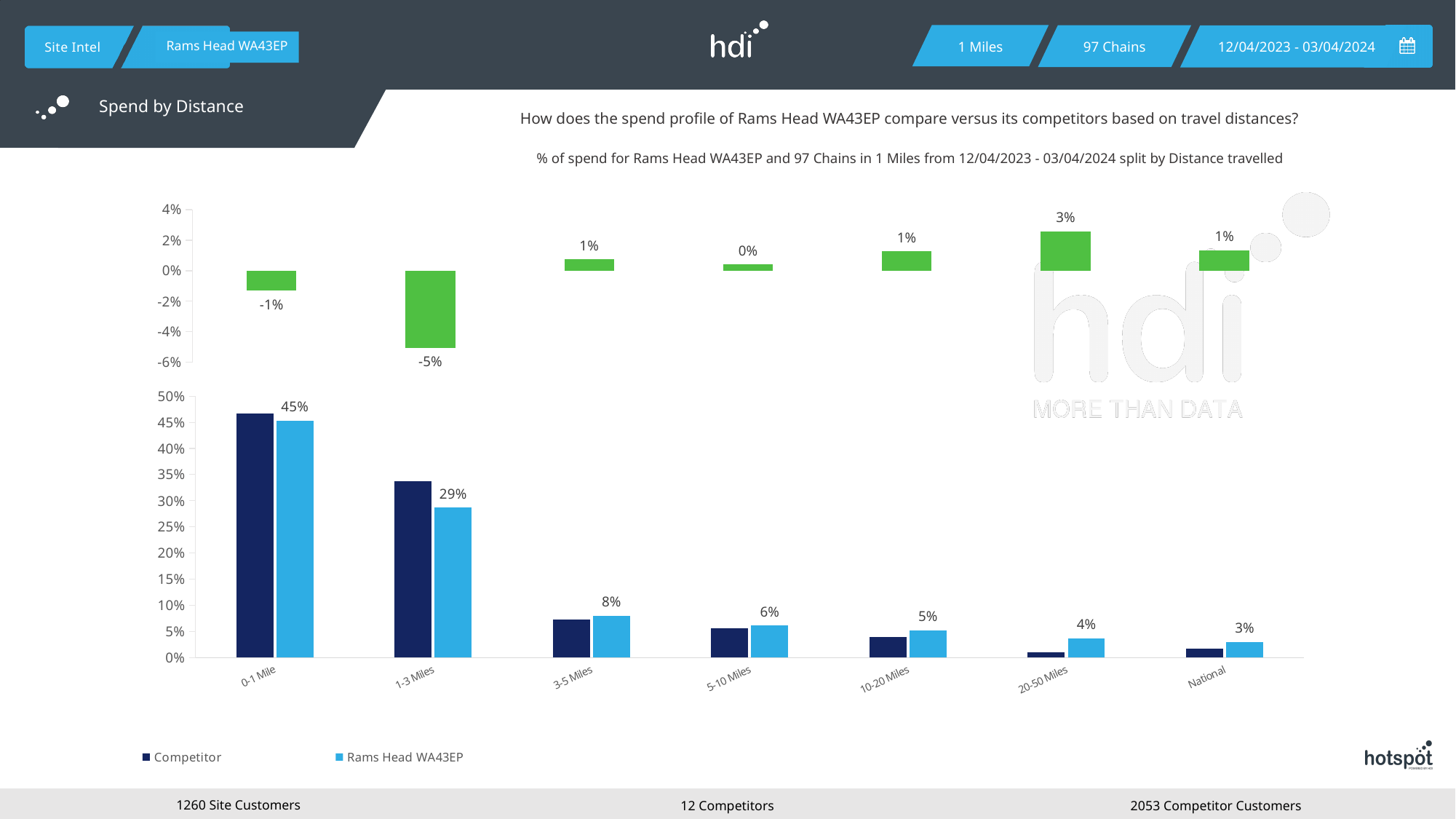
In the bottom chart, which distance category has the lowest value for Rams Head WA43EP? National In the bottom chart, what is the difference between the Rams Head WA43EP values for 0-1 Mile and 1-3 Miles? 16 percentage points How many distance categories are shown on the x axis of the bottom chart? 7 In the bottom chart, for the 0-1 Mile category, which is larger: the Competitor value or the Rams Head WA43EP value? Competitor In the bottom chart, is the Competitor value for 1-3 Miles greater or less than 30%? greater In the top green chart, what is the value for the 1-3 Miles category? -5% In the bottom chart, which distance category has the highest value for Rams Head WA43EP? 0-1 Mile In the bottom chart, is the Competitor value for 20-50 Miles greater or less than 5%? less In the top green chart, which distance category has the highest value? 20-50 Miles In the bottom chart, what is the value for Rams Head WA43EP in the 0-1 Mile category? 45% In the bottom chart, what is the value for Rams Head WA43EP in the 3-5 Miles category? 8% How many series does the legend of the bottom chart list? 2